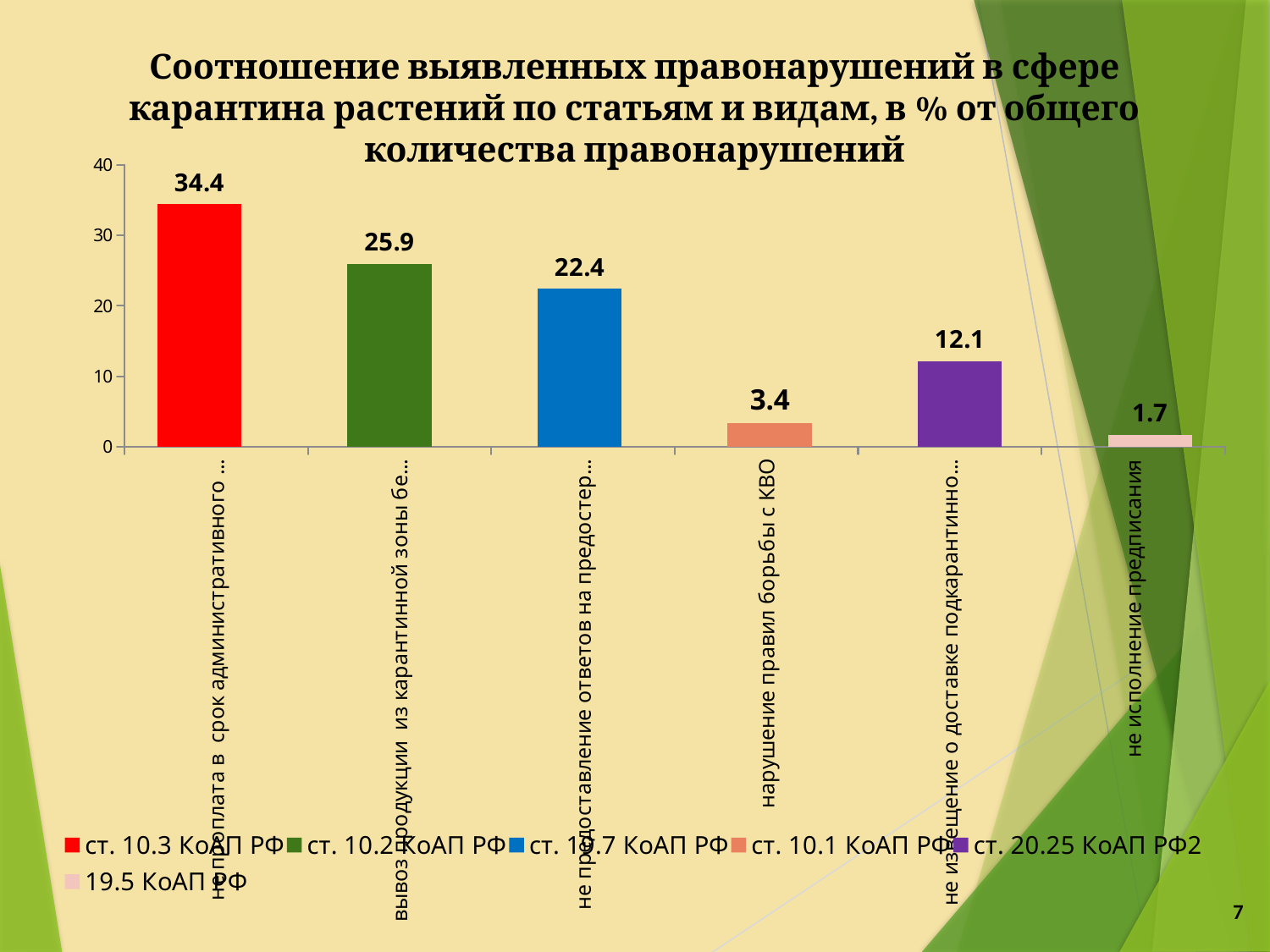
Which category has the lowest value in the chart? не исполнение предписания Which series has the highest value in the chart? ст. 10.3 КоАП РФ What is the value of the bar for the series "ст. 10.3 КоАП РФ" (the red bar)? 34.4 What is the value of the bar for the series "ст. 19.7 КоАП РФ" (the blue bar)? 22.4 Which is larger: the value for "нарушение правил борьбы с КВО" or the value for "не исполнение предписания"? нарушение правил борьбы с КВО What is the value for the category "не исполнение предписания"? 1.7 What is the value for the category "нарушение правил борьбы с КВО"? 3.4 What is the value of the bar for the series "ст. 20.25 КоАП РФ2" (the purple bar)? 12.1 What is the value of the bar for the series "ст. 10.2 КоАП РФ" (the green bar)? 25.9 How many bars are plotted in the chart? 6 What is the difference between the values for "ст. 10.3 КоАП РФ" and "ст. 10.2 КоАП РФ"? 8.5 What type of chart is shown on the slide? bar chart